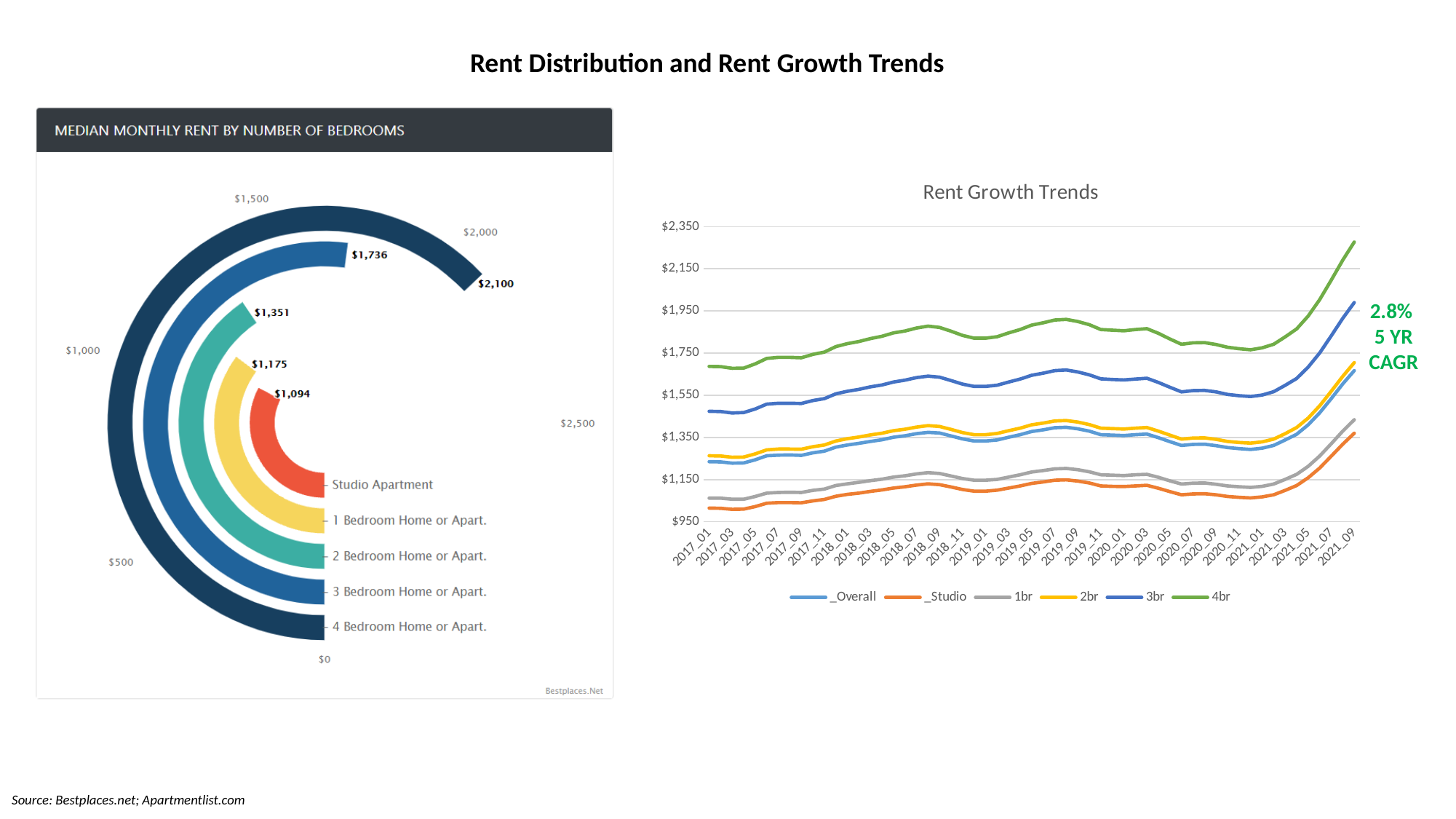
In the Median Monthly Rent by Number of Bedrooms chart, which category has the lowest median monthly rent? Studio Apartment How many categories are shown in the Median Monthly Rent by Number of Bedrooms chart? 5 How many series does the legend of the Rent Growth Trends chart list? 6 In the Median Monthly Rent by Number of Bedrooms chart, what is the difference between the median rent for a 4 Bedroom Home or Apart. and a 3 Bedroom Home or Apart.? $364 In the Median Monthly Rent by Number of Bedrooms chart, what is the median monthly rent for a 4 Bedroom Home or Apart.? $2,100 In the Rent Growth Trends chart, does the 4br series rise or fall between 2021_01 and 2021_09? Rise In the Rent Growth Trends chart, is the value for 4br at 2021_09 greater or less than $2,150? greater In the Median Monthly Rent by Number of Bedrooms chart, which category has the highest median monthly rent? 4 Bedroom Home or Apart. In the Median Monthly Rent by Number of Bedrooms chart, which has the higher median rent: 1 Bedroom Home or Apart. or 2 Bedroom Home or Apart.? 2 Bedroom Home or Apart. In the Median Monthly Rent by Number of Bedrooms chart, what is the median monthly rent for a Studio Apartment? $1,094 In the Rent Growth Trends chart, is the value for _Studio at 2017_01 greater or less than $1,150? less What kind of chart is the Rent Growth Trends chart? Line chart